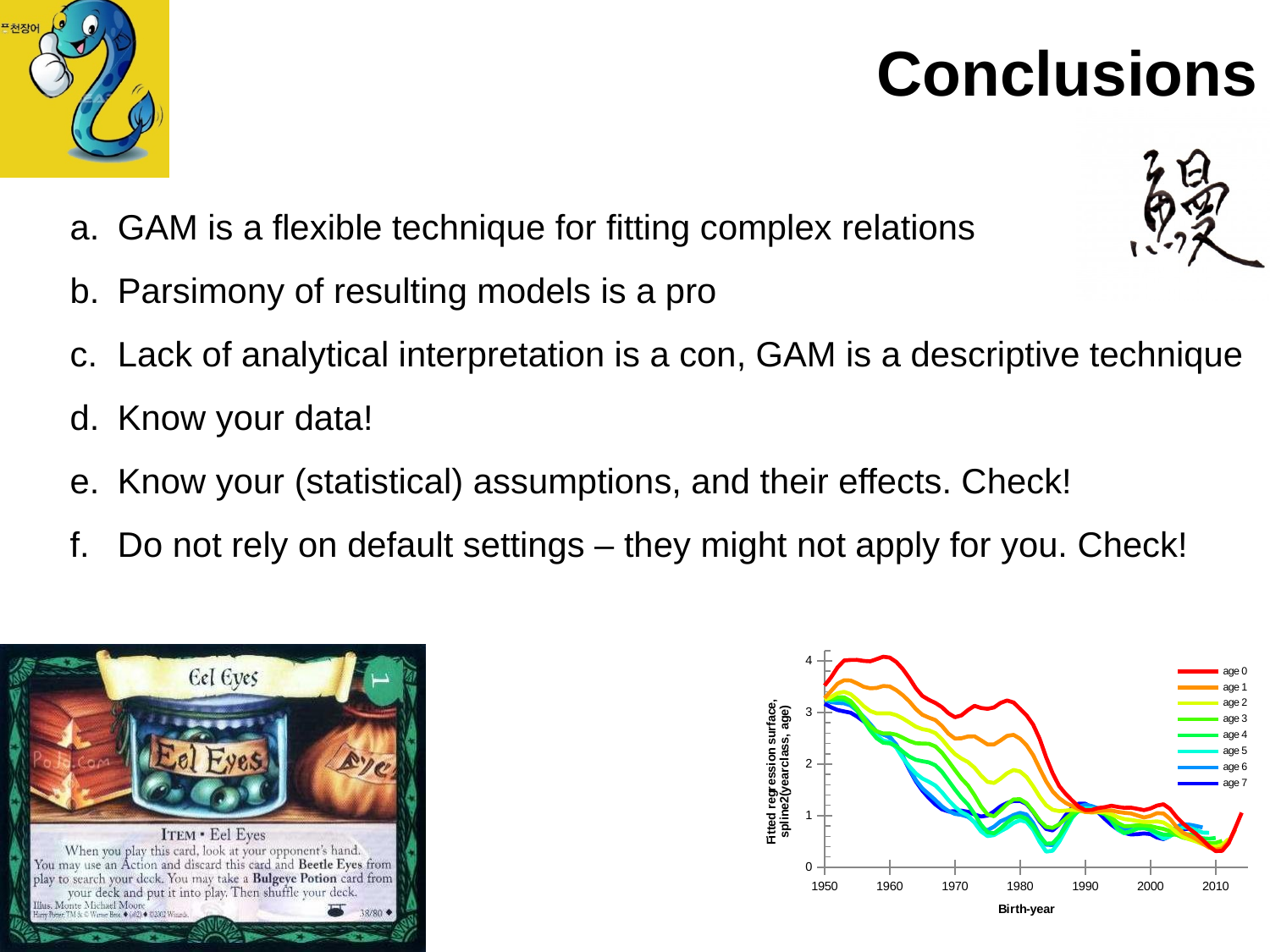
Is the fitted value for age 7 at birth-year 1960 greater or less than 3? less At birth-year 1980, which is larger: the fitted value for age 0 or for age 3? age 0 How many series does the legend of the chart list? 8 Which series is shown in red in the chart's legend? age 0 What is the title of the x axis of the chart? Birth-year Which series has the highest fitted value at birth-year 1960? age 0 Which series has the highest fitted value at birth-year 1980? age 0 At birth-year 1960, which is larger: the fitted value for age 0 or for age 7? age 0 Overall, do the fitted values in the chart rise or fall as birth-year increases from 1950 to 2010? fall Is the fitted value for age 0 at birth-year 2010 greater or less than 1? less What kind of chart is shown at the bottom right of the slide? line chart